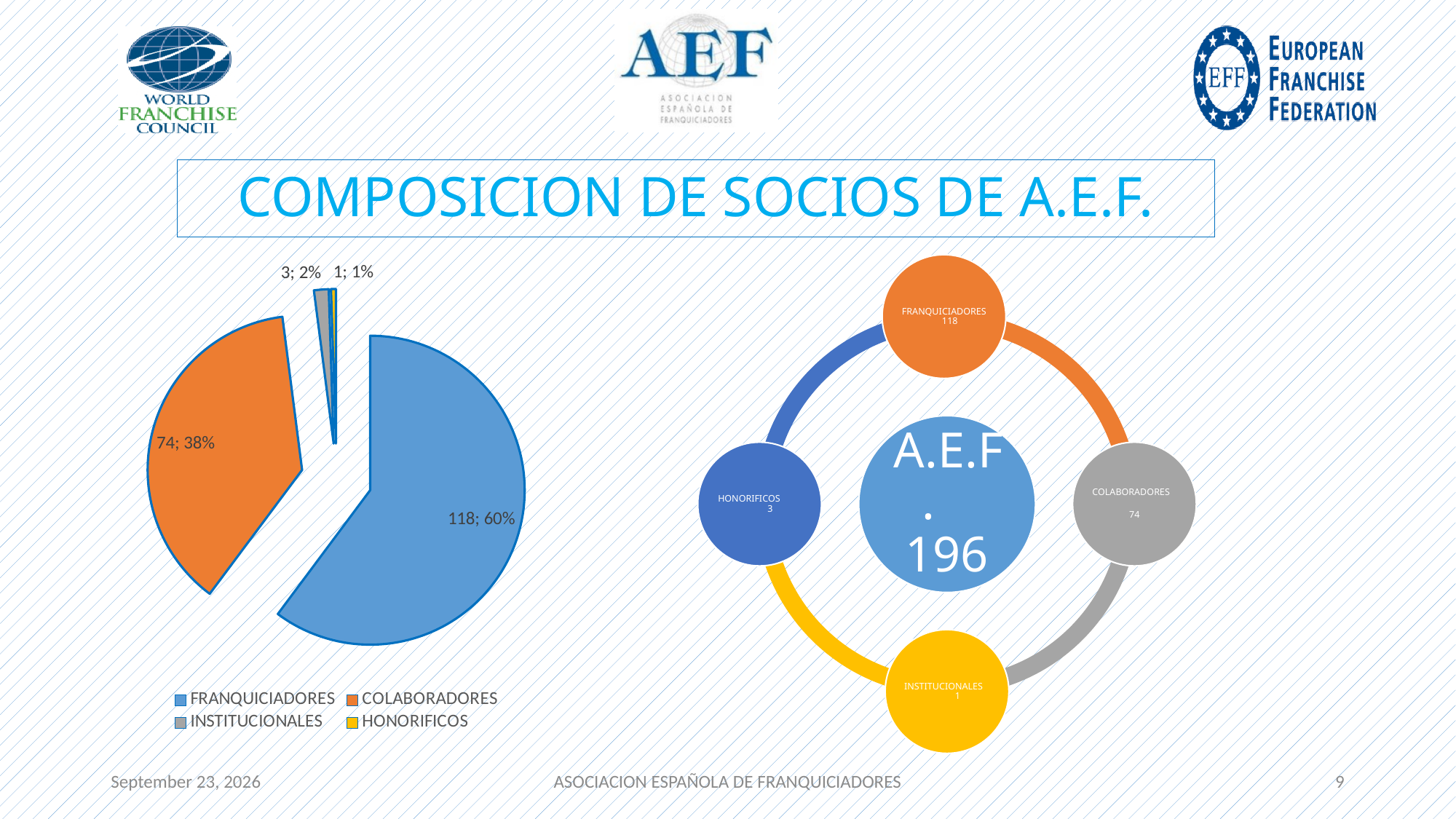
How many categories does the pie chart's legend list? 4 In the pie chart, what share of the pie does FRANQUICIADORES represent? 60% In the pie chart, what colour is the COLABORADORES slice? orange In the pie chart, what is the value for COLABORADORES? 74 In the pie chart, which category has the largest slice? FRANQUICIADORES What is the title of the slide above the pie chart? COMPOSICION DE SOCIOS DE A.E.F. In the pie chart, what is the difference between the values for FRANQUICIADORES and COLABORADORES? 44 In the pie chart, what is the value for FRANQUICIADORES? 118 In the pie chart, what share of the pie does COLABORADORES represent? 38% What kind of chart is shown on the left of the slide? pie chart What is the total of all the values shown in the pie chart? 196 In the pie chart, which is larger, FRANQUICIADORES or COLABORADORES? FRANQUICIADORES